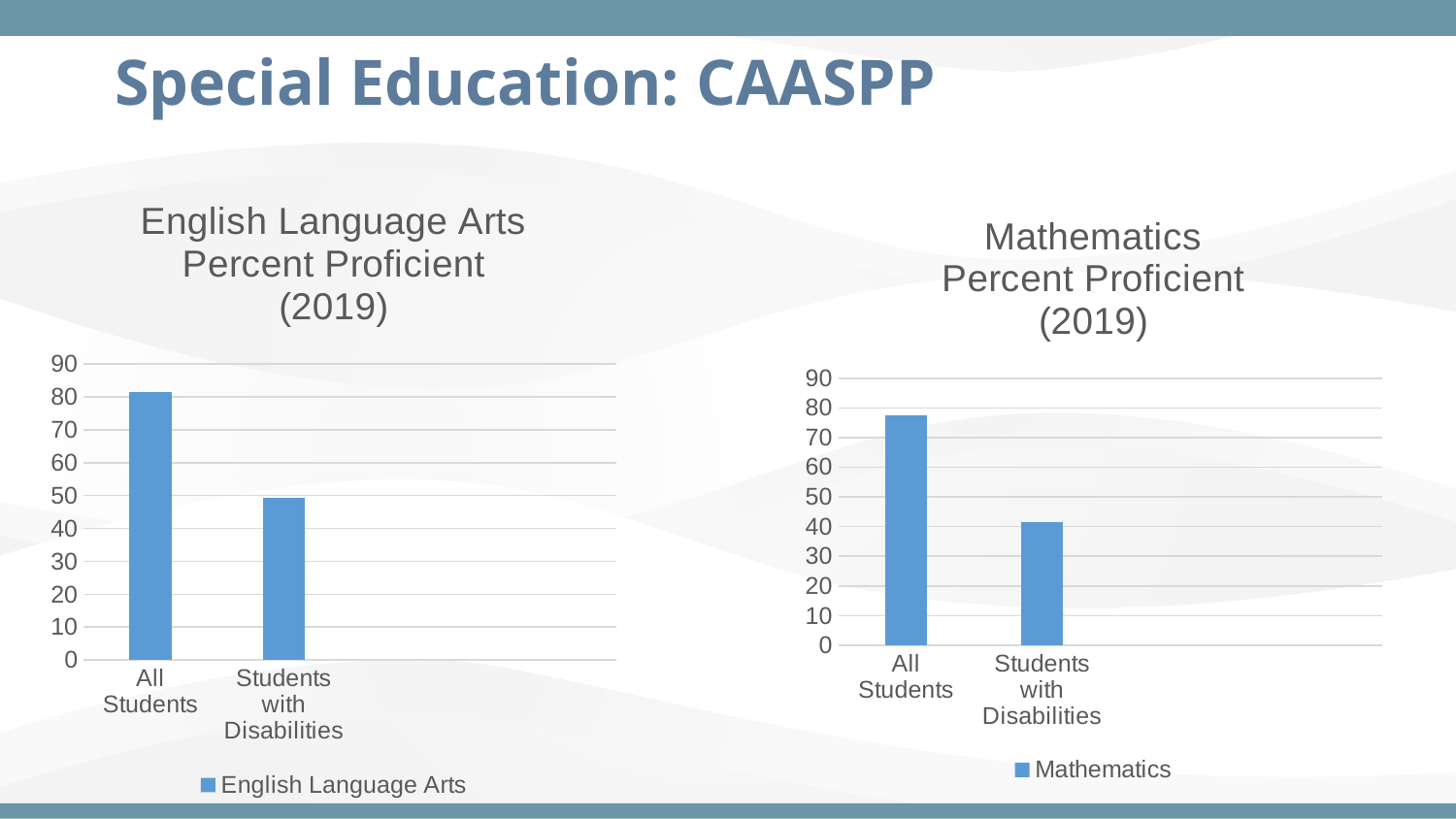
What kind of chart is the English Language Arts Percent Proficient (2019) chart? bar chart In the Mathematics Percent Proficient (2019) chart, which category has the highest value? All Students In the Mathematics Percent Proficient (2019) chart, is the value for All Students greater or less than 70? greater In the English Language Arts Percent Proficient (2019) chart, is the value for All Students greater or less than 80? greater In the English Language Arts Percent Proficient (2019) chart, which category has the highest value? All Students In the Mathematics Percent Proficient (2019) chart, is the value for Students with Disabilities greater or less than 50? less What is the legend entry shown below the English Language Arts Percent Proficient (2019) chart? English Language Arts In the English Language Arts Percent Proficient (2019) chart, which category has the lowest value? Students with Disabilities How many categories are shown in the English Language Arts Percent Proficient (2019) chart? 2 In the Mathematics Percent Proficient (2019) chart, which is larger: the value for All Students or the value for Students with Disabilities? All Students How many series does the legend of the Mathematics Percent Proficient (2019) chart list? 1